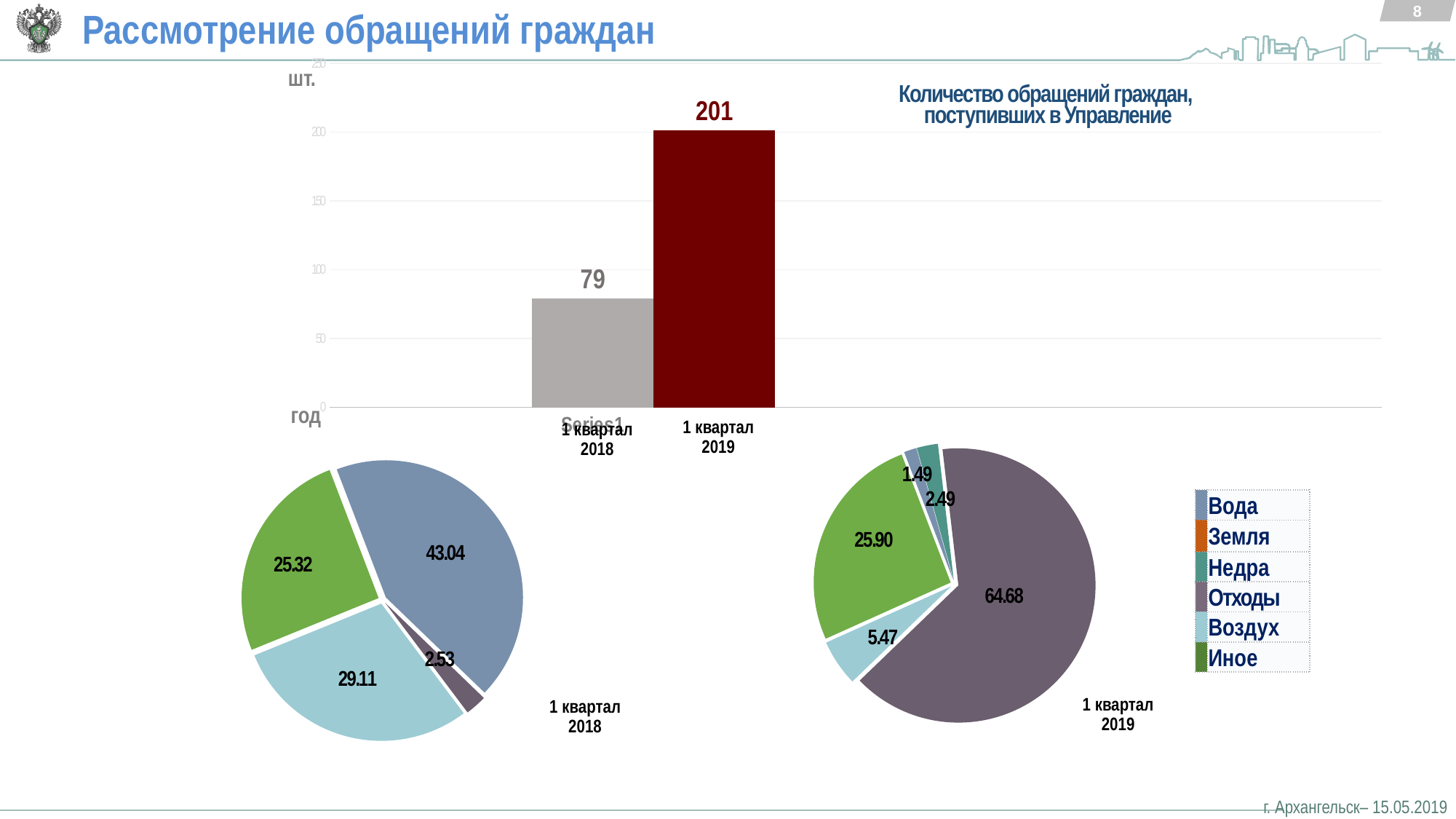
How many entries does the legend next to the pie charts list? 6 In the bar chart 'Количество обращений граждан, поступивших в Управление', how many bars are plotted? 2 In the pie chart labelled '1 квартал 2018', what is the smallest labelled slice value? 2.53 In the bar chart 'Количество обращений граждан, поступивших в Управление', what is the value for 1 квартал 2019? 201 In the bar chart 'Количество обращений граждан, поступивших в Управление', by how much does the value for 1 квартал 2019 exceed the value for 1 квартал 2018? 122 In the pie chart labelled '1 квартал 2018', what is the largest slice value? 43.04 In the bar chart 'Количество обращений граждан, поступивших в Управление', what is the value for 1 квартал 2018? 79 In the pie chart labelled '1 квартал 2019', what is the value of the largest slice? 64.68 What kind of chart is the chart at the top of the slide titled 'Количество обращений граждан, поступивших в Управление'? bar chart In the bar chart 'Количество обращений граждан, поступивших в Управление', which period has the higher value? 1 квартал 2019 In the pie chart labelled '1 квартал 2019', what is the difference between the largest slice (64.68) and the green slice (25.90)? 38.78 In the pie chart labelled '1 квартал 2019', what is the value of the smallest labelled slice? 1.49